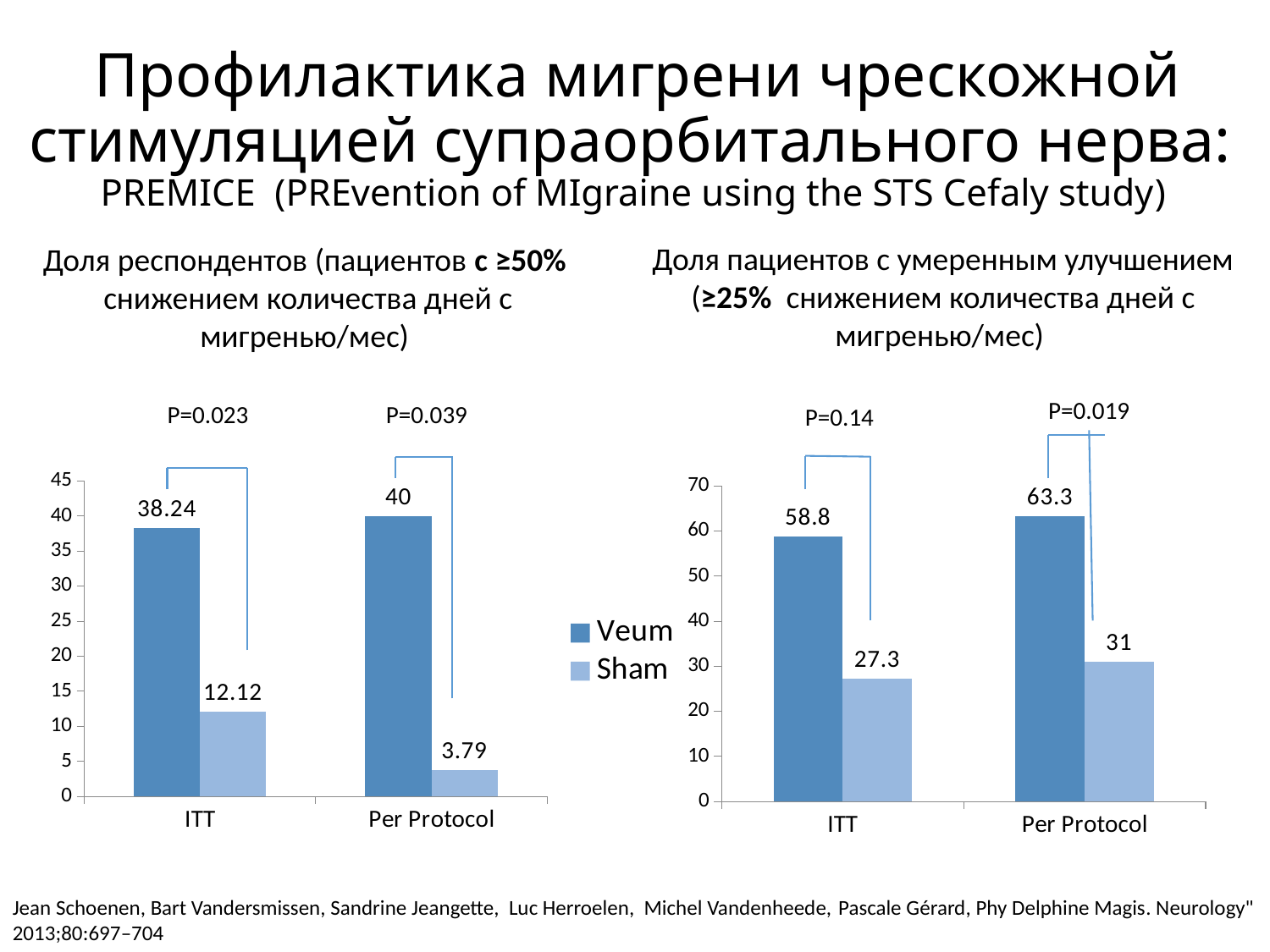
In the left chart (≥50% responders), what is the difference between Veum and Sham in the ITT group? 26.12 What kind of chart is the left chart (≥50% responders)? Bar chart How many series does the legend list? 2 In the right chart (≥25% improvement), which is larger in the ITT group: Veum or Sham? Veum What P value is shown above the Per Protocol group in the right chart (≥25% improvement)? P=0.019 In the right chart (≥25% improvement), what is the value for Veum in the Per Protocol group? 63.3 In the left chart (≥50% responders), what is the value for Veum in the ITT group? 38.24 In the right chart (≥25% improvement), what is the value for Sham in the ITT group? 27.3 In the right chart (≥25% improvement), which bar is the highest? Veum, Per Protocol In the left chart (≥50% responders), which bar is the lowest? Sham, Per Protocol In the right chart (≥25% improvement), what is the difference between Veum and Sham in the Per Protocol group? 32.3 In the left chart (≥50% responders), what is the value for Sham in the Per Protocol group? 3.79